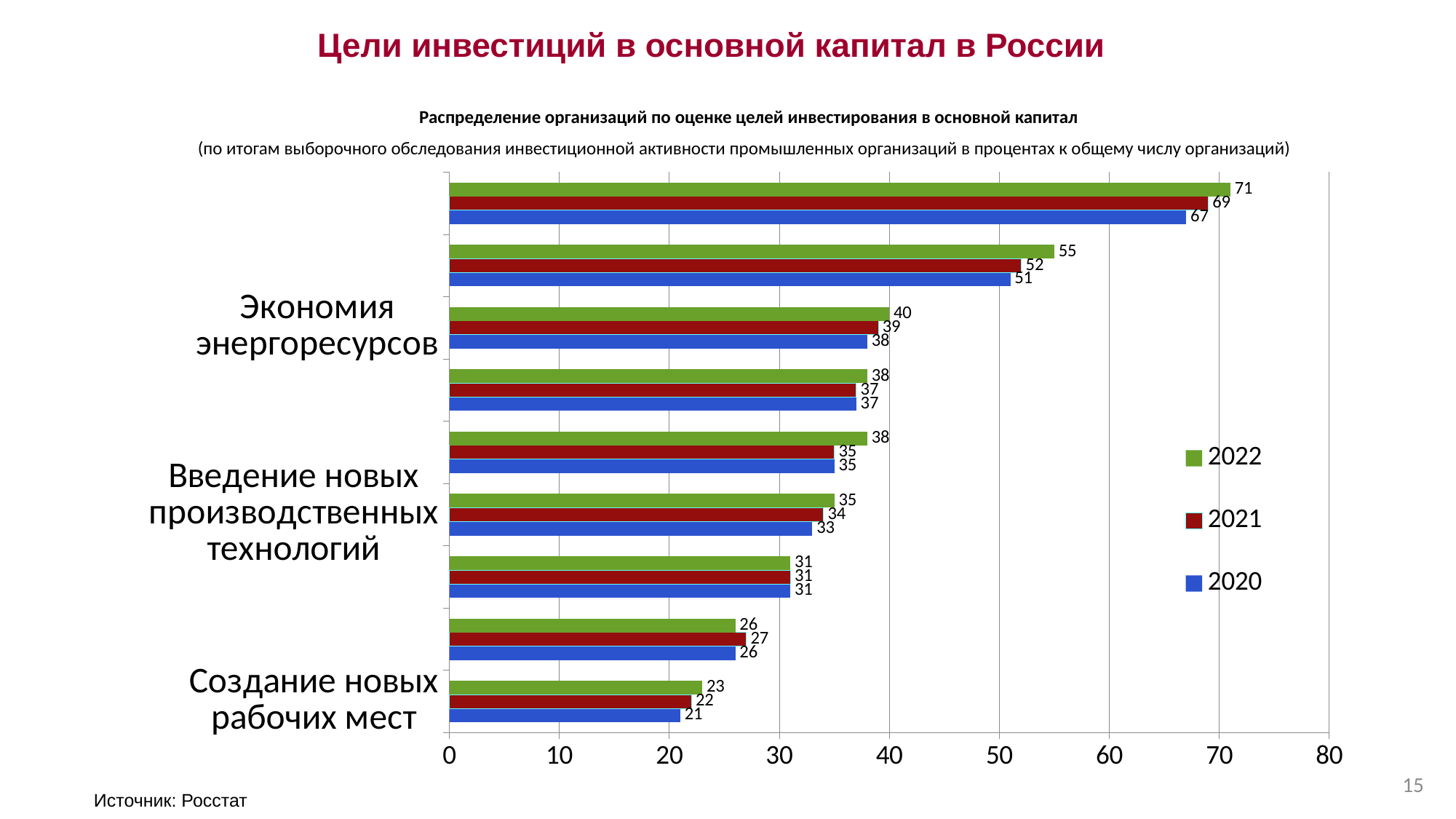
What is the value for Создание новых рабочих мест in 2022? 23 What is the difference between the 2022 and 2020 values for Экономия энергоресурсов? 2 Which colour represents the 2020 series in the legend? Blue Which year has the higher value for Создание новых рабочих мест, 2022 or 2020? 2022 What is the value for Экономия энергоресурсов in 2022? 40 Which year has the highest value for Введение новых производственных технологий? 2022 What is the value for Введение новых производственных технологий in 2021? 34 What is the value for Создание новых рабочих мест in 2020? 21 Is the 2022 value for Экономия энергоресурсов greater or less than 30? greater What kind of chart is shown on the slide? Bar chart What is the value for Экономия энергоресурсов in 2020? 38 How many series does the legend list? 3